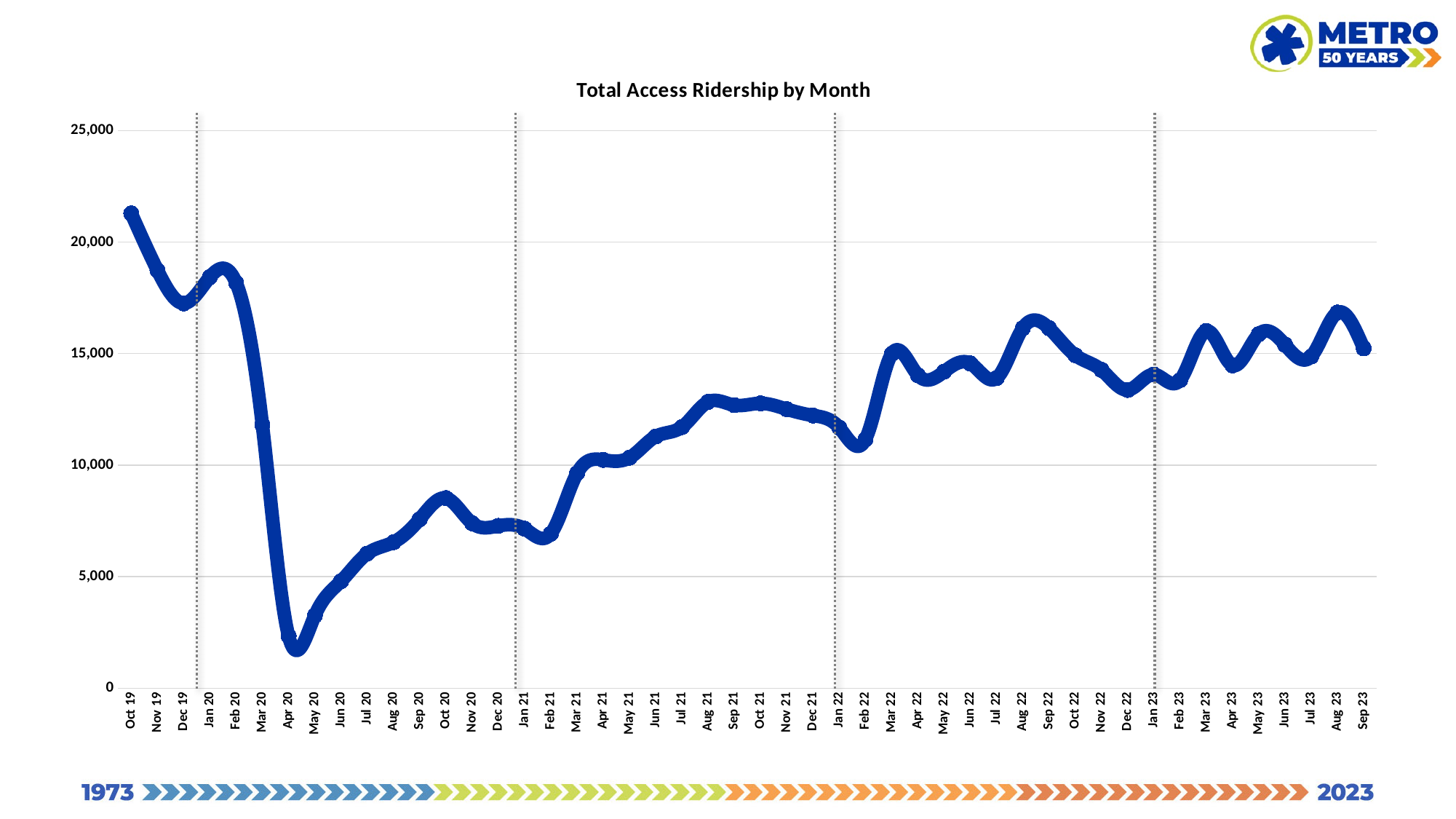
Which month has the lowest total Access ridership? Apr 20 Is the value for Feb 21 greater or less than 10,000? less Is the value for Apr 20 greater or less than 5,000? less Which month has the highest total Access ridership? Oct 19 Does the ridership rise or fall from Oct 19 to Apr 20? fall How many monthly data points are plotted on the chart? 48 Is the value for Jan 20 greater or less than 15,000? greater Which is larger, the value for Aug 22 or the value for Feb 22? Aug 22 What kind of chart is shown on the slide? line chart What is the title of the chart? Total Access Ridership by Month